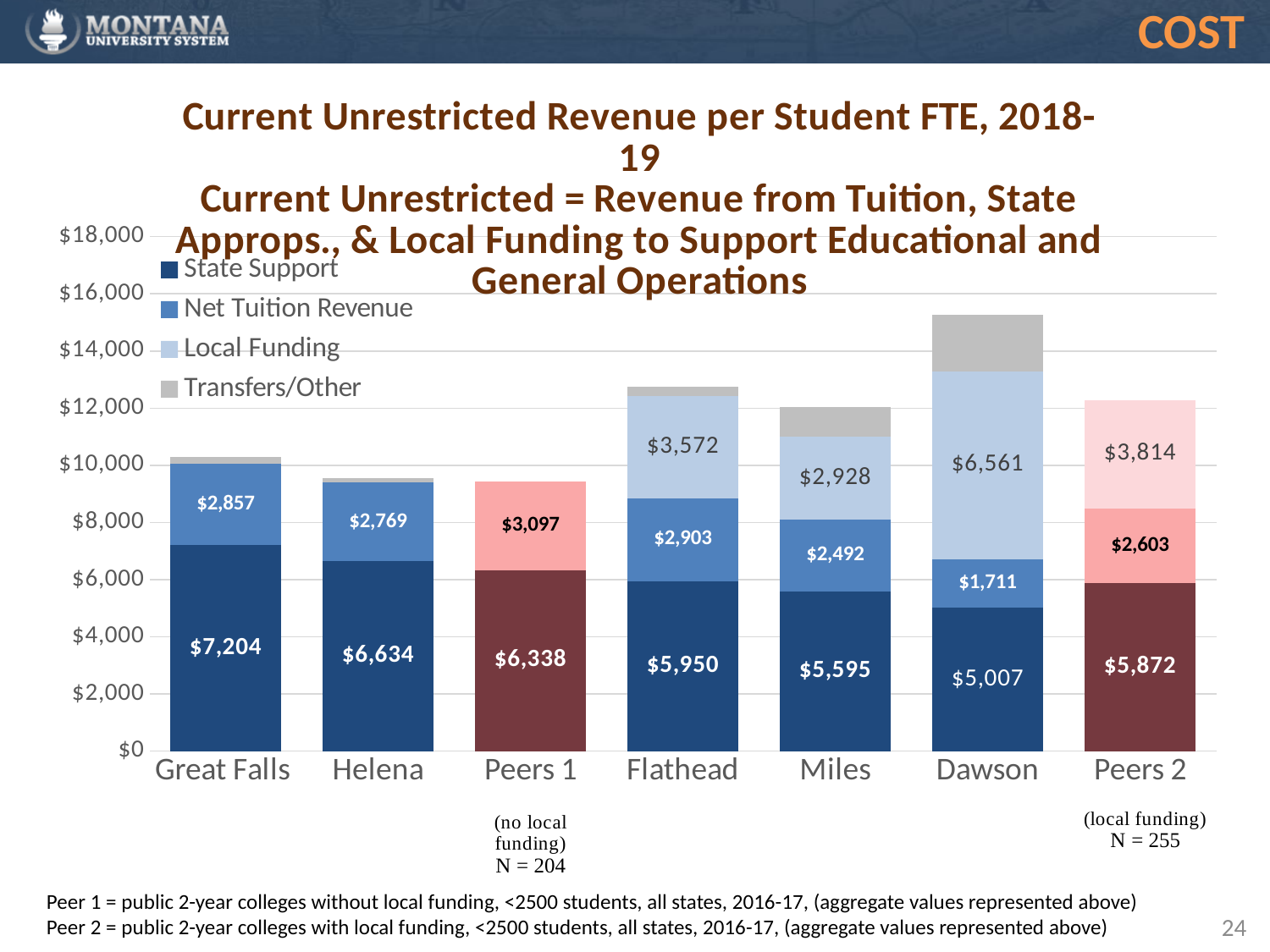
What is the total of the Peers 1 stacked bar? $9,435 Which category has the lowest State Support value? Dawson What is the State Support value for Great Falls? $7,204 How many series does the legend list? 4 Is the total height of the Helena bar greater or less than $10,000? less What is the Local Funding value for Dawson? $6,561 Which category has the highest State Support value? Great Falls Which has the larger Local Funding value, Flathead or Miles? Flathead How many categories are shown on the x axis? 7 What is the Net Tuition Revenue value for Miles? $2,492 What is the difference between the State Support values for Great Falls and Helena? $570 Is the total height of the Dawson bar greater or less than $14,000? greater